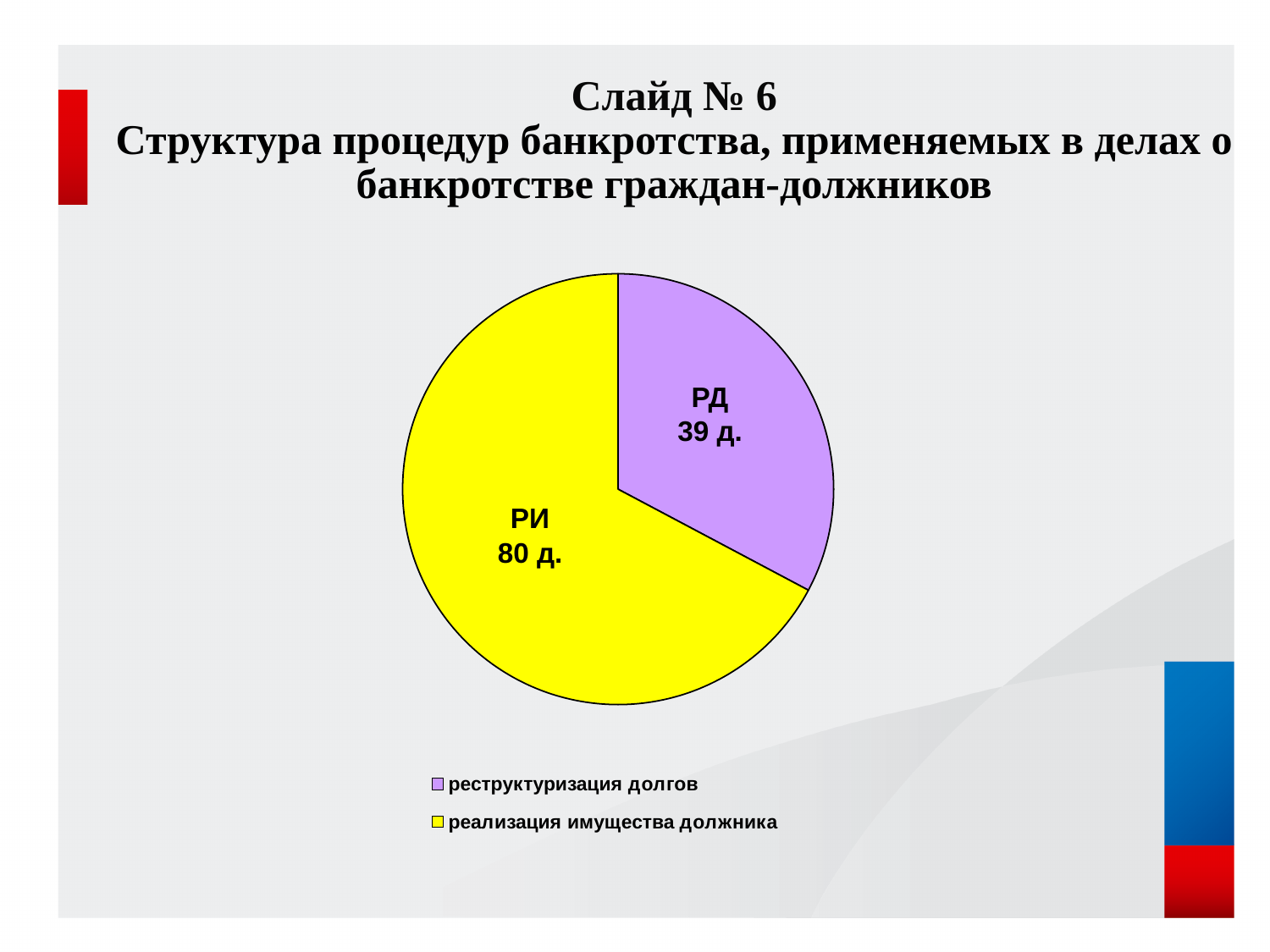
How many slices does the pie chart have? 2 What colour is the slice for реструктуризация долгов? purple What is the value shown for the РИ slice? 80 д. Which slice is the smallest? РД What is the value shown for the РД slice? 39 д. How many entries does the legend list? 2 Which slice is the largest? РИ What is the total of the two slices? 119 д. What kind of chart is shown on the slide? pie chart Which legend entry corresponds to the yellow slice? реализация имущества должника Which is larger, РД or РИ? РИ What is the difference between the РИ and РД values? 41 д.